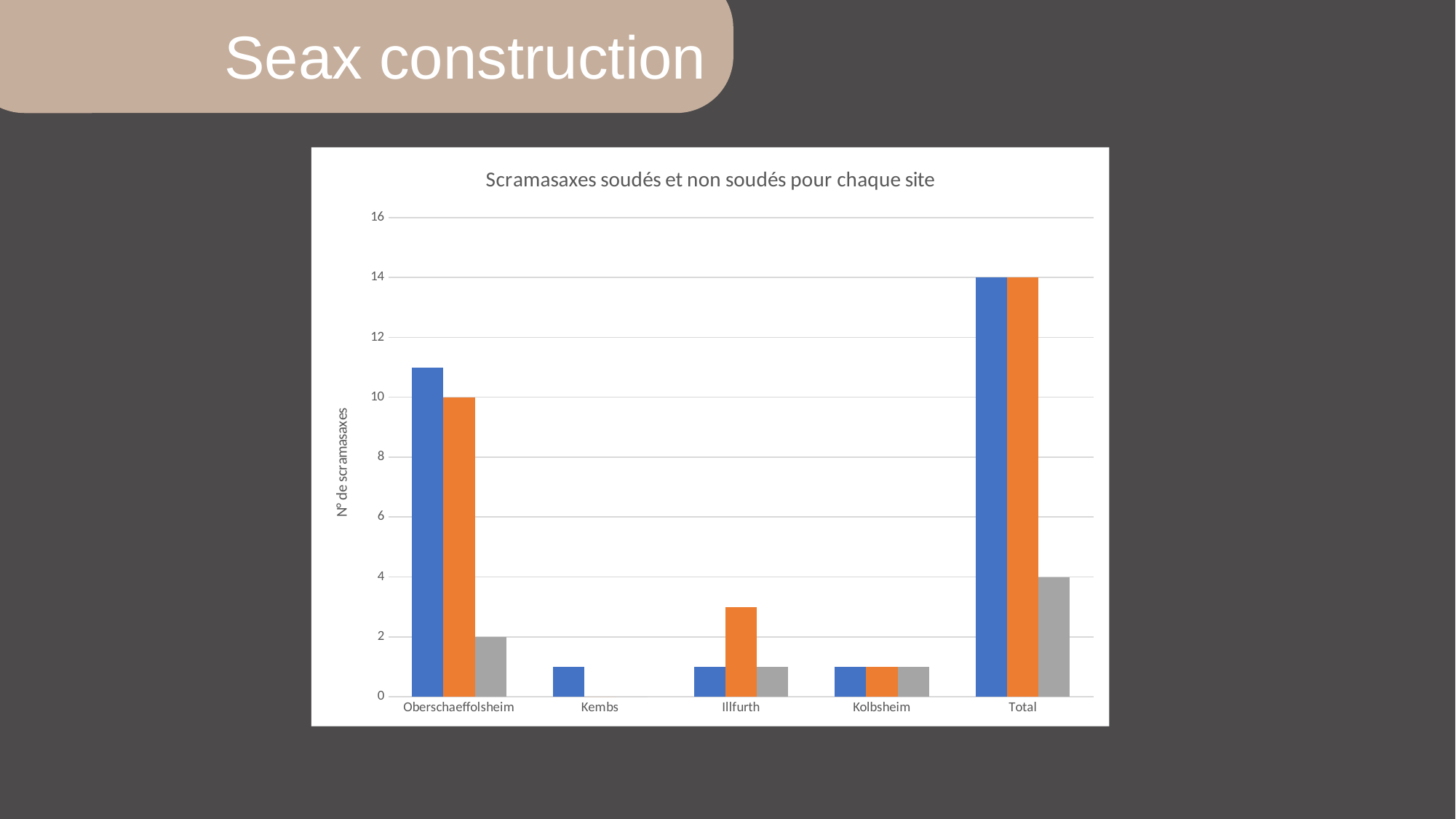
What is the value of the grey bar for Total? 4 What is the value of the grey bar for Oberschaeffolsheim? 2 What is the difference between the grey bar for Total and the grey bar for Oberschaeffolsheim? 2 Is the value of the blue bar for Kembs greater or less than 2? less Is the value of the orange bar for Illfurth greater or less than 2? greater What type of chart is shown on the slide? bar chart What is the value of the orange bar for Oberschaeffolsheim? 10 Which category has the tallest blue bar? Total What is the label of the vertical axis? N° de scramasaxes What is the title of the chart? Scramasaxes soudés et non soudés pour chaque site What is the value of the blue bar for Total? 14 How many categories are shown on the x axis of the chart? 5